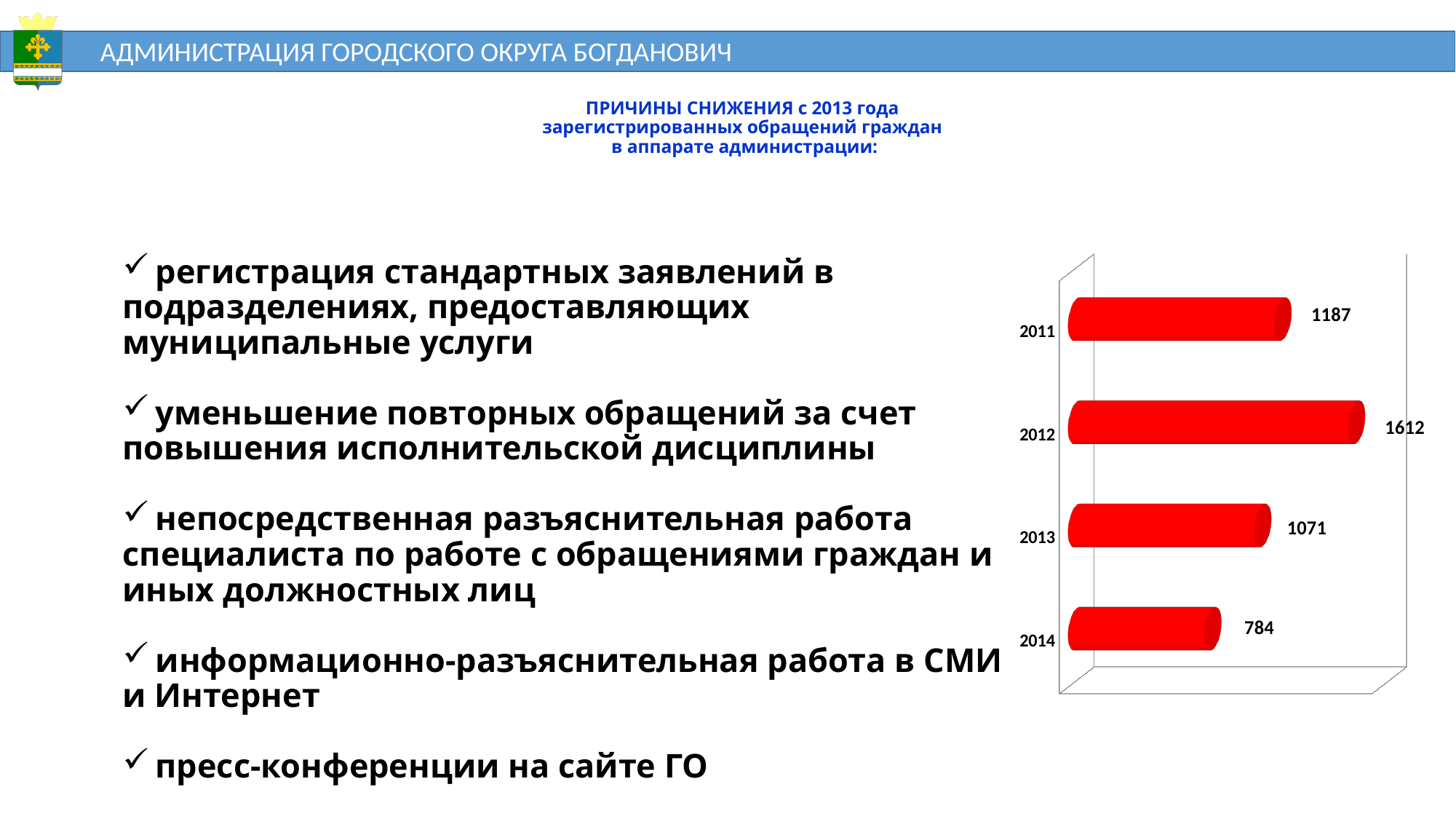
What is the value shown for 2011? 1187 What is the value shown for 2013? 1071 What colour are the bars in the chart? red What is the difference between the values for 2012 and 2013? 541 Which year has the lowest value? 2014 What is the difference between the values for 2013 and 2014? 287 How many years are shown in the chart? 4 What is the value shown for 2014? 784 What is the value shown for 2012? 1612 Which year has the highest value? 2012 Which is larger, the value for 2011 or the value for 2013? 2011 What kind of chart is shown on the slide? bar chart